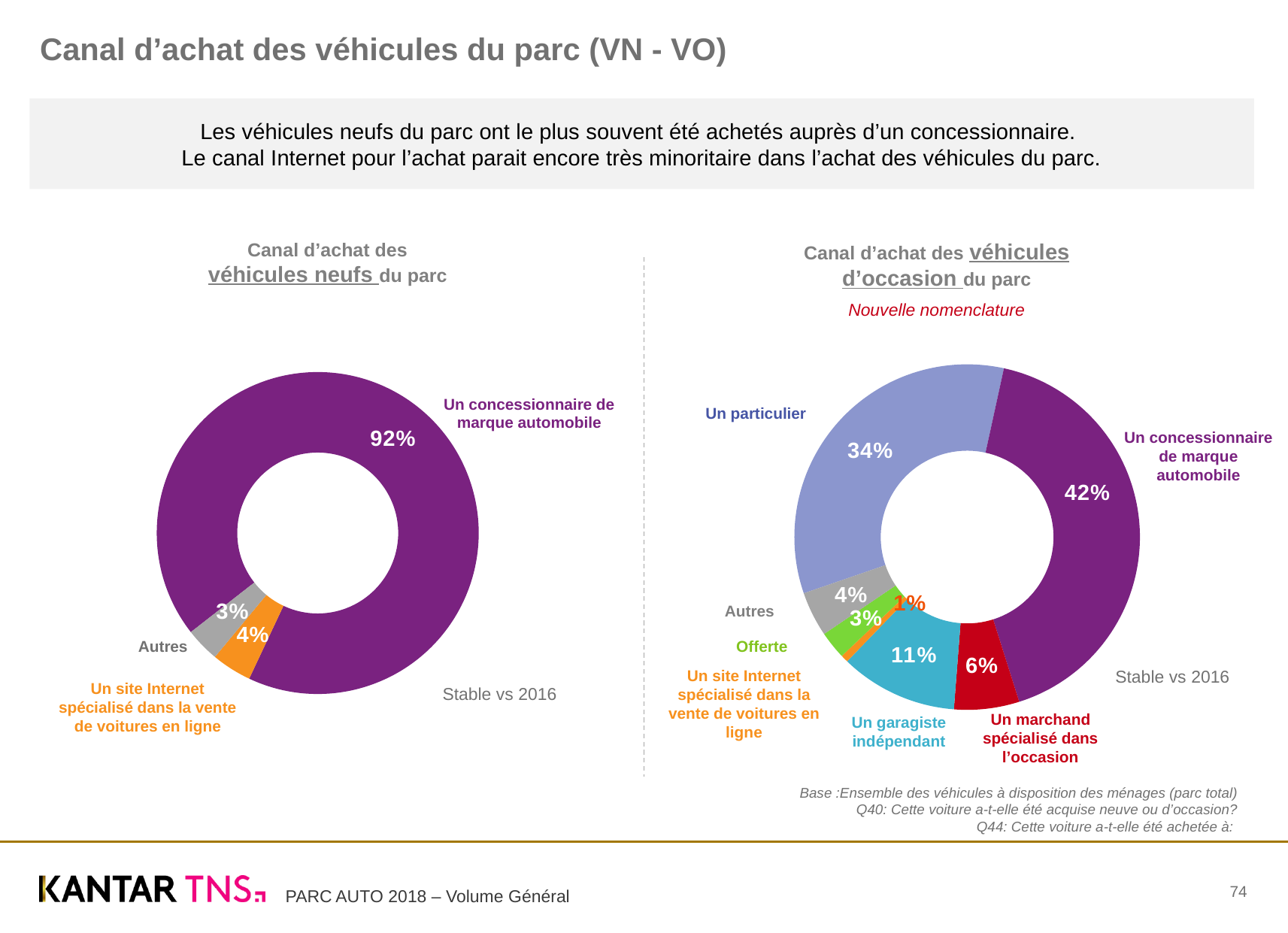
In the chart 'Canal d'achat des véhicules d'occasion du parc', which is larger: 'Un marchand spécialisé dans l'occasion' or 'Offerte'? Un marchand spécialisé dans l'occasion What type of chart is used on this slide for both 'Canal d'achat' charts? Donut (pie) chart In the chart 'Canal d'achat des véhicules neufs du parc', how many slices does the donut have? 3 In the chart 'Canal d'achat des véhicules d'occasion du parc', which category has the smallest share? Un site Internet spécialisé dans la vente de voitures en ligne In the chart 'Canal d'achat des véhicules neufs du parc', what is the value for 'Un site Internet spécialisé dans la vente de voitures en ligne'? 4% In the chart 'Canal d'achat des véhicules d'occasion du parc', what is the difference between 'Un concessionnaire de marque automobile' and 'Un particulier'? 8 percentage points In the chart 'Canal d'achat des véhicules d'occasion du parc', how many categories are shown? 7 In the chart 'Canal d'achat des véhicules d'occasion du parc', what is the value for 'Un garagiste indépendant'? 11% In the chart 'Canal d'achat des véhicules neufs du parc', what is the value for 'Autres'? 3% In the chart 'Canal d'achat des véhicules d'occasion du parc', which category has the largest share? Un concessionnaire de marque automobile In the chart 'Canal d'achat des véhicules neufs du parc', what share of new vehicles was bought from 'Un concessionnaire de marque automobile'? 92% In the chart 'Canal d'achat des véhicules d'occasion du parc', what is the value for 'Un particulier'? 34%